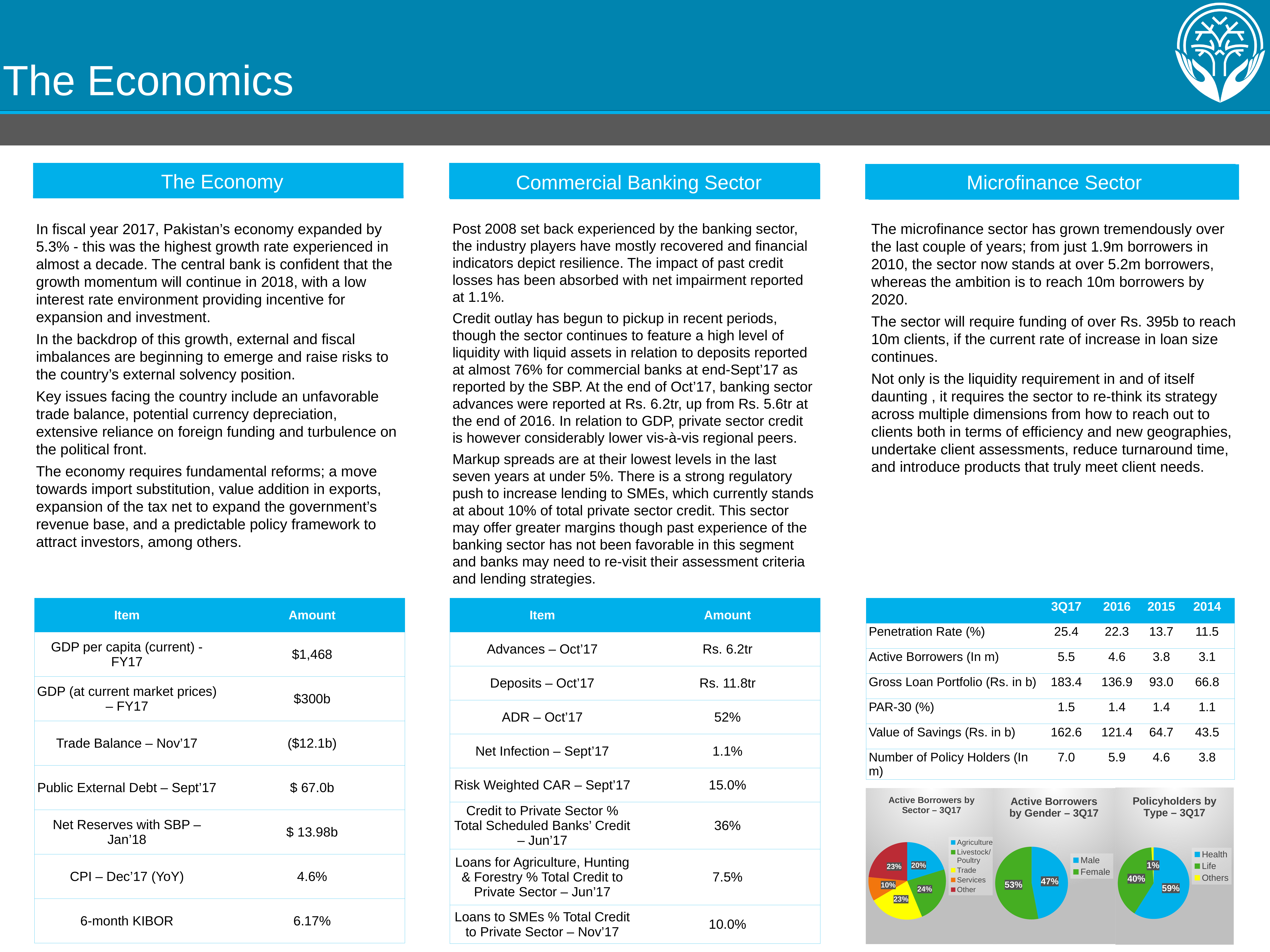
In the 'Policyholders by Type – 3Q17' chart, which type has the smallest share? Others In the 'Policyholders by Type – 3Q17' chart, what share is Life? 40% In the 'Active Borrowers by Sector – 3Q17' chart, which sector has the largest share? Livestock/Poultry What kind of chart is 'Active Borrowers by Gender – 3Q17'? Pie chart In the 'Active Borrowers by Gender – 3Q17' chart, what share is Male? 47% How many categories does the legend of the 'Active Borrowers by Sector – 3Q17' chart list? 5 In the 'Policyholders by Type – 3Q17' chart, what share is Health? 59% In the 'Policyholders by Type – 3Q17' chart, which is larger, Health or Life? Health In the 'Active Borrowers by Gender – 3Q17' chart, what is the difference between the Female and Male shares? 6% In the 'Active Borrowers by Sector – 3Q17' chart, which sector has the smallest share? Services In the 'Active Borrowers by Gender – 3Q17' chart, what share is Female? 53% In the 'Active Borrowers by Sector – 3Q17' chart, what share is Services? 10%